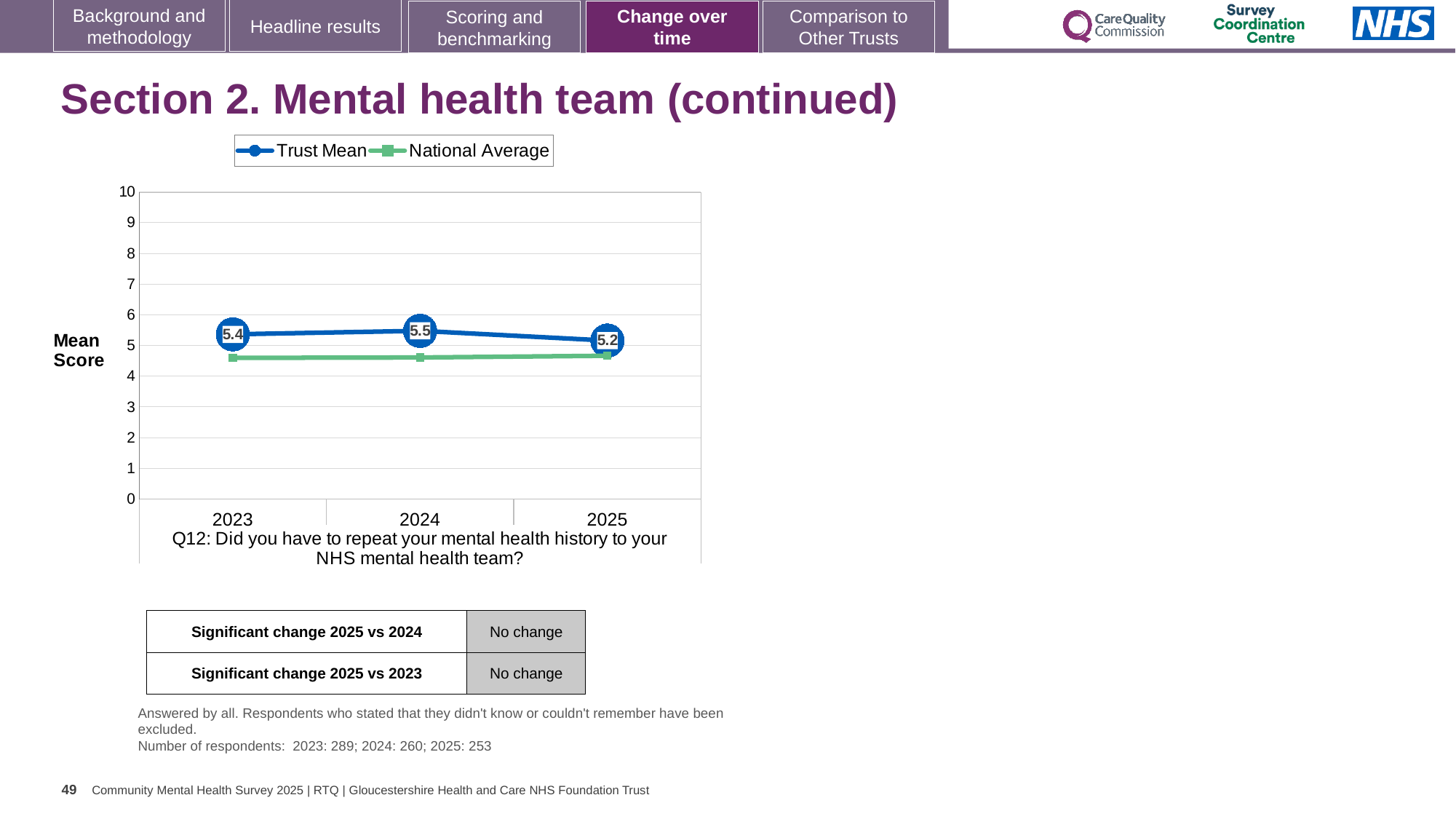
What is the Trust Mean score for 2025? 5.2 What kind of chart is shown on the slide? line chart In which year is the Trust Mean score lowest? 2025 What is the Trust Mean score for 2023? 5.4 In which year is the Trust Mean score highest? 2024 How many series does the legend list? 2 Does the Trust Mean rise or fall from 2024 to 2025? fall Is the National Average value for 2024 greater or less than 5? less What is the Trust Mean score for 2024? 5.5 How many years are plotted on the x axis? 3 What is the difference between the Trust Mean scores for 2024 and 2025? 0.3 Which is larger in 2023, the Trust Mean or the National Average? Trust Mean